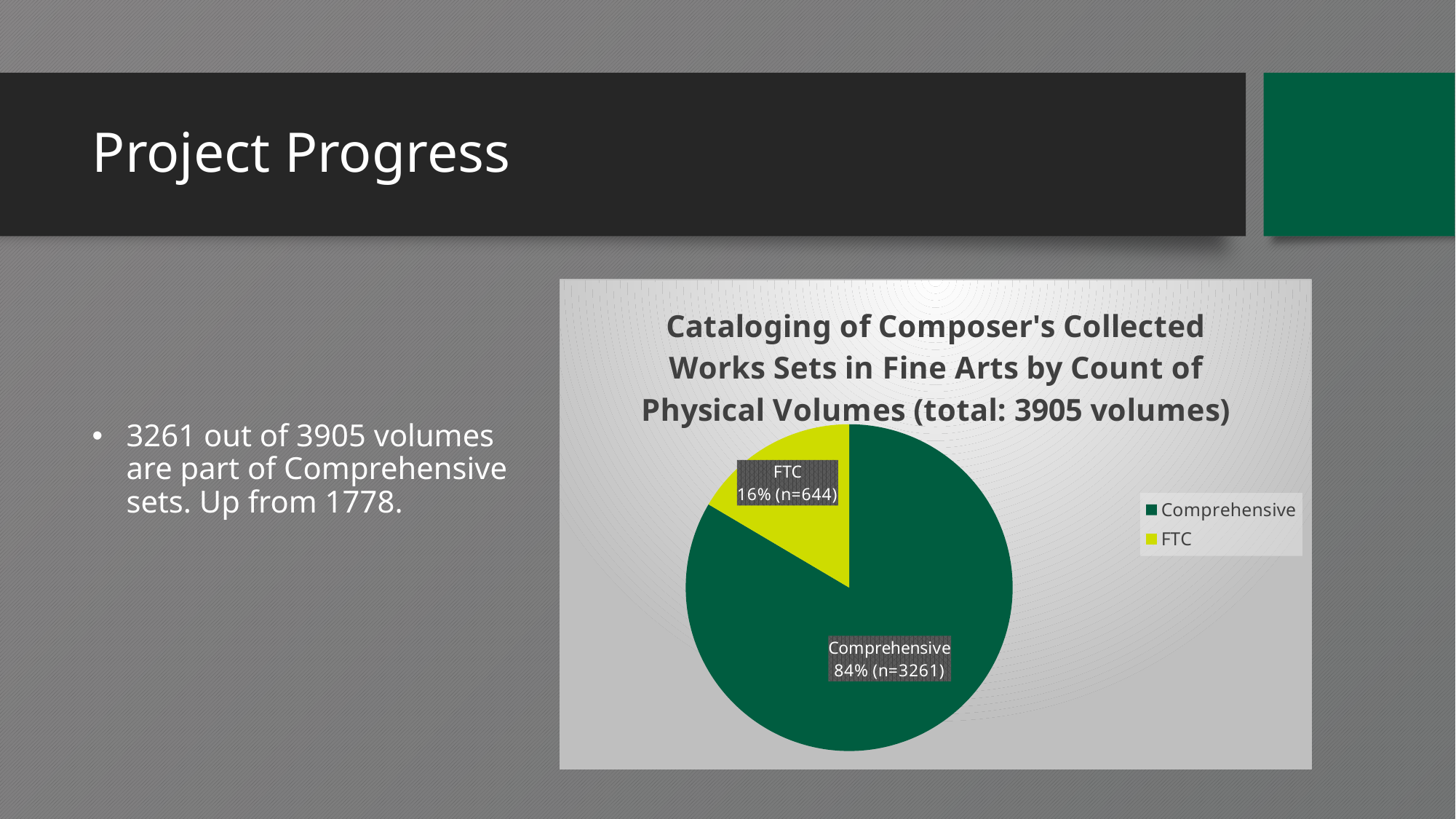
What is the count of volumes for the FTC slice? 644 How many entries does the legend list? 2 Which slice is the smallest? FTC What kind of chart is shown on the slide? pie chart What is the title of the chart? Cataloging of Composer's Collected Works Sets in Fine Arts by Count of Physical Volumes (total: 3905 volumes) What is the count of volumes for the Comprehensive slice? 3261 What share of the pie does the FTC slice represent? 16% What share of the pie does the Comprehensive slice represent? 84% Which colour is used for the FTC slice? yellow-green Which slice is the largest? Comprehensive How many slices does the pie chart have? 2 What is the difference in volume count between the Comprehensive and FTC slices? 2617